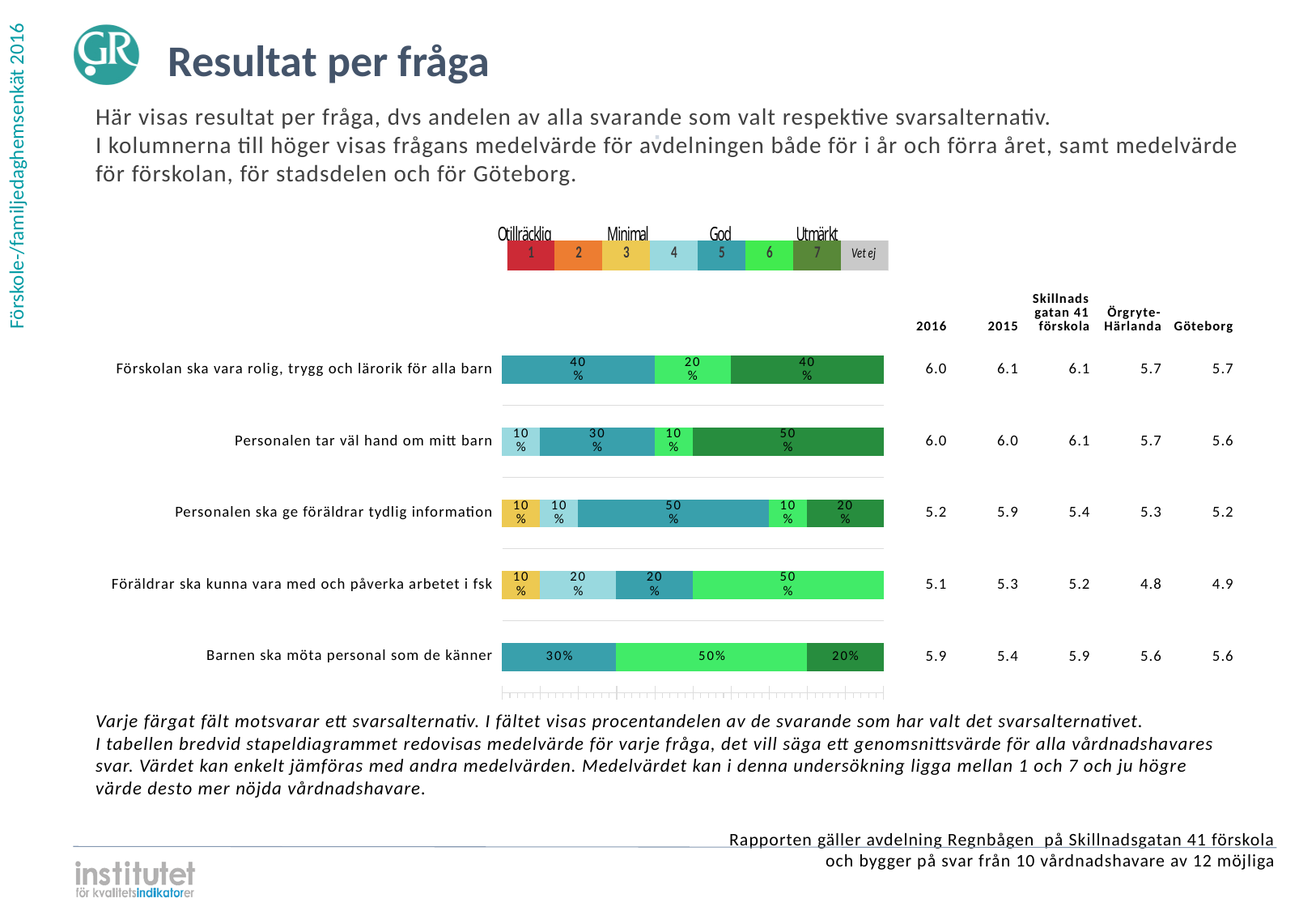
What percentage of respondents chose option 7 (dark green) for 'Förskolan ska vara rolig, trygg och lärorik för alla barn'? 40% What is the largest segment in the bar for 'Personalen ska ge föräldrar tydlig information'? 50% What label does the legend give to response options 5 and 6? God How many questions (bars) are shown in the chart? 5 What is the 2016 mean value for 'Personalen ska ge föräldrar tydlig information'? 5.2 Which question has the lowest 2016 mean value in the table? Föräldrar ska kunna vara med och påverka arbetet i fsk What percentage of respondents chose option 7 (dark green) for 'Personalen tar väl hand om mitt barn'? 50% Which is larger for 'Föräldrar ska kunna vara med och påverka arbetet i fsk': the option 6 segment or the option 4 segment? Option 6 segment (50%) What is the difference between the option 6 segment (50%) and the option 5 segment (30%) for 'Barnen ska möta personal som de känner'? 20% What percentage of respondents chose option 6 (light green) for 'Barnen ska möta personal som de känner'? 50% What is the total of all segments in the bar for 'Barnen ska möta personal som de känner'? 100% What kind of chart is shown on the slide? Stacked bar chart